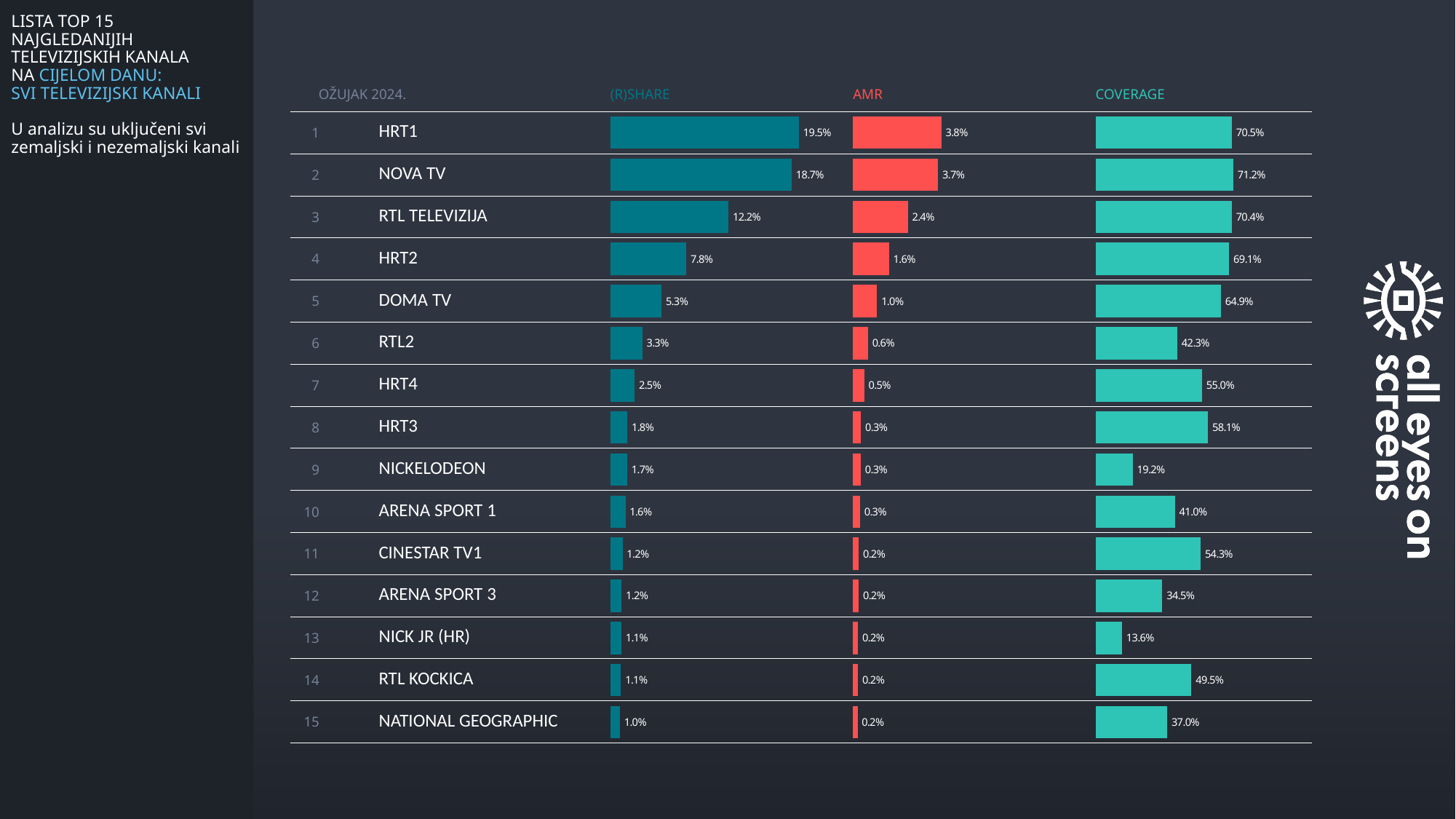
What kind of chart is used to show the (R)SHARE, AMR and COVERAGE values? Bar chart Which channel has the lowest COVERAGE value? NICK JR (HR) What is the difference between the COVERAGE values of RTL TELEVIZIJA and RTL2? 28.1% What is the difference between the (R)SHARE values of HRT1 and NOVA TV? 0.8% Do the (R)SHARE values rise or fall going down the list from rank 1 to rank 15? Fall How many channels are listed in the chart? 15 What is the (R)SHARE value for HRT1? 19.5% Which month and year does the chart cover, as shown in the header? OŽUJAK 2024. Which channel has the highest COVERAGE value? NOVA TV What is the COVERAGE value for DOMA TV? 64.9% Which channel has the larger COVERAGE value, HRT4 or HRT3? HRT3 What is the AMR value for NOVA TV? 3.7%